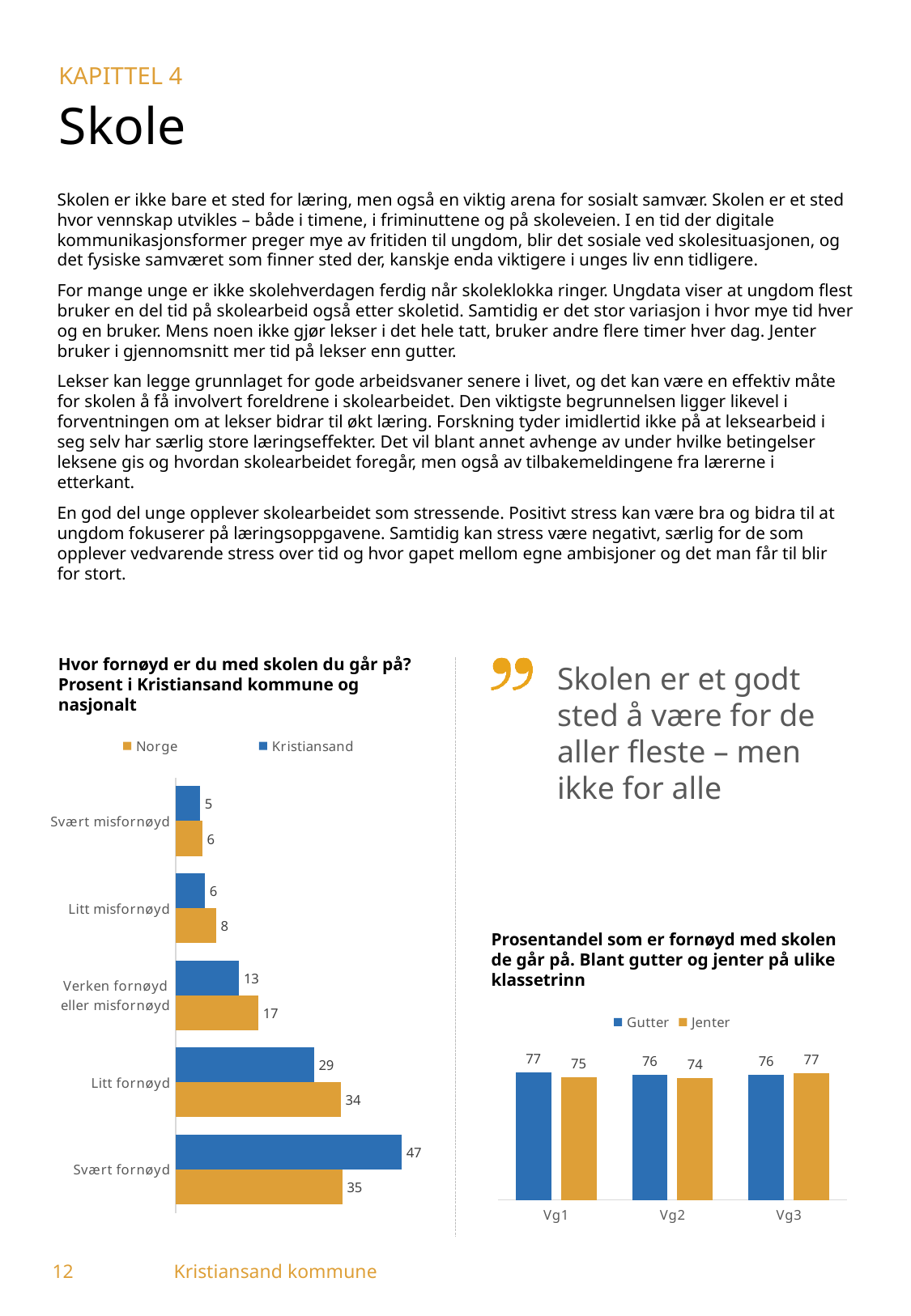
In the chart 'Hvor fornøyd er du med skolen du går på?', what is the value for Kristiansand in the category 'Svært fornøyd'? 47 In the chart 'Hvor fornøyd er du med skolen du går på?', what is the difference between the Kristiansand and Norge values for 'Svært fornøyd'? 12 In the chart 'Prosentandel som er fornøyd med skolen de går på', what is the difference between Gutter and Jenter at Vg1? 2 What type of chart is 'Hvor fornøyd er du med skolen du går på?'? Bar chart How many categories are shown in the chart 'Hvor fornøyd er du med skolen du går på?'? 5 In the chart 'Prosentandel som er fornøyd med skolen de går på', which is larger at Vg3: Gutter or Jenter? Jenter In the chart 'Hvor fornøyd er du med skolen du går på?', what is the value for Norge in the category 'Litt fornøyd'? 34 In the chart 'Hvor fornøyd er du med skolen du går på?', which category has the highest value for Kristiansand? Svært fornøyd In the chart 'Hvor fornøyd er du med skolen du går på?', which category has the lowest value for Norge? Svært misfornøyd In the chart 'Hvor fornøyd er du med skolen du går på?', which is larger for 'Verken fornøyd eller misfornøyd': Norge or Kristiansand? Norge In the chart 'Prosentandel som er fornøyd med skolen de går på', what is the value for Jenter at Vg2? 74 How many series does the legend list in the chart 'Prosentandel som er fornøyd med skolen de går på'? 2